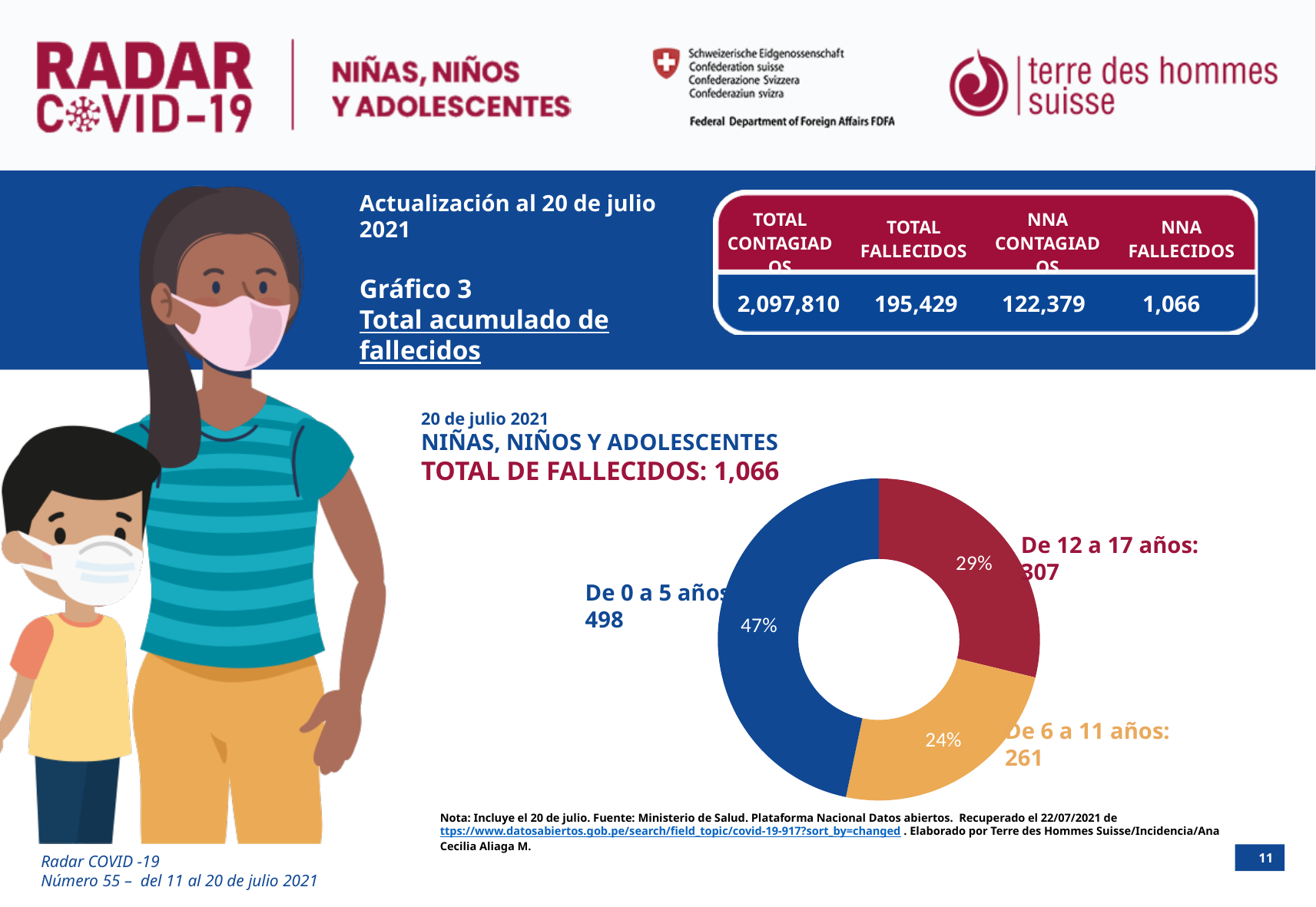
What percentage of the donut chart corresponds to 'De 0 a 5 años'? 47% What total number of deaths is stated in the chart heading 'TOTAL DE FALLECIDOS'? 1,066 What percentage of the donut chart corresponds to 'De 6 a 11 años'? 24% Which age group has the lowest number of deaths in the donut chart? De 6 a 11 años What kind of chart is shown on the slide? Donut (pie) chart What is the difference in deaths between 'De 0 a 5 años' and 'De 6 a 11 años'? 237 What is the number of deaths for the group 'De 0 a 5 años'? 498 What is the number of deaths for the group 'De 6 a 11 años'? 261 Which group has more deaths, 'De 12 a 17 años' or 'De 6 a 11 años'? De 12 a 17 años What percentage of the donut chart corresponds to 'De 12 a 17 años'? 29% How many age groups are shown in the donut chart? 3 Which age group has the highest number of deaths in the donut chart? De 0 a 5 años